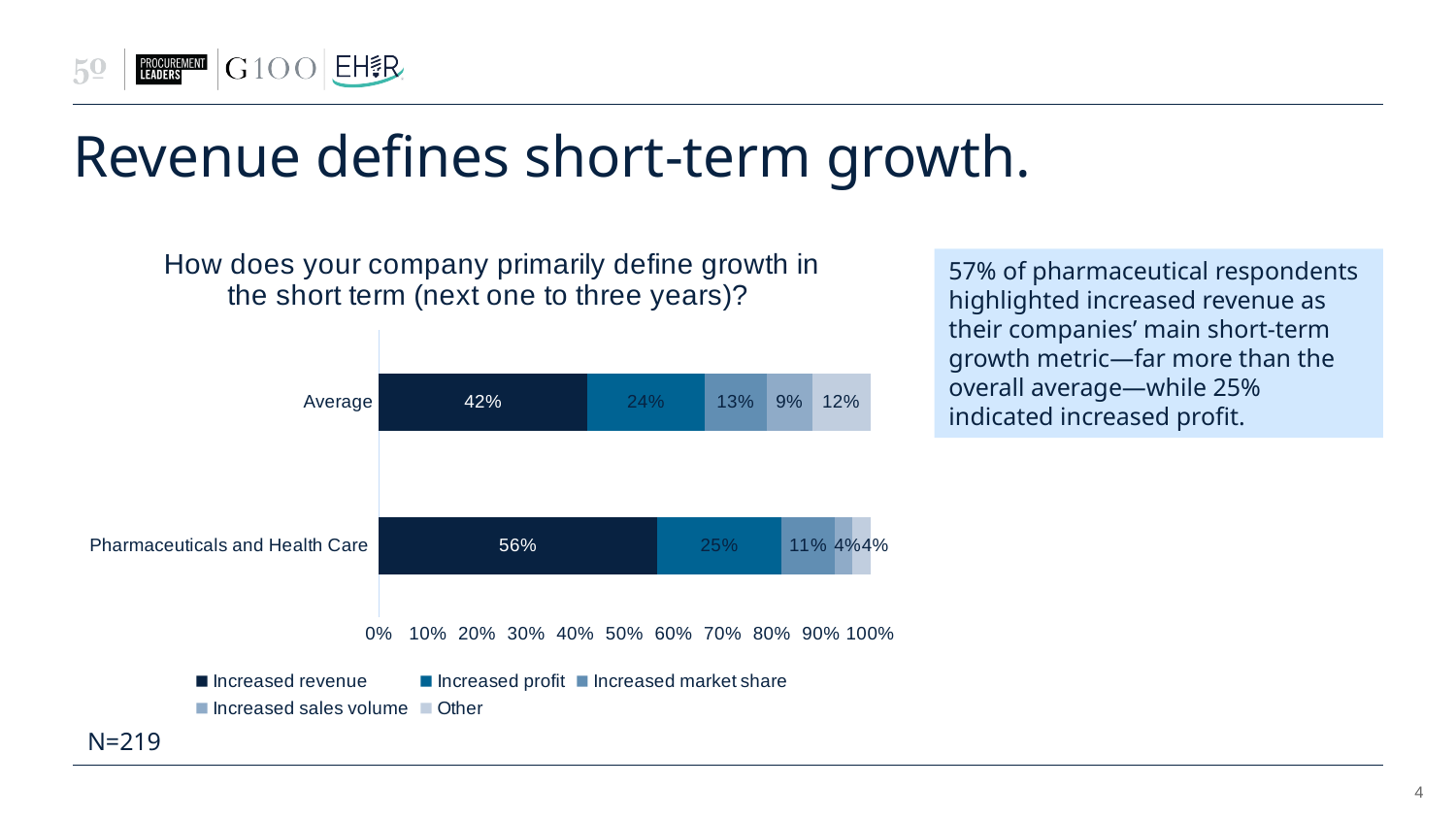
Which has a larger Increased profit value, Average or Pharmaceuticals and Health Care? Pharmaceuticals and Health Care What percentage of Pharmaceuticals and Health Care respondents chose Increased market share? 11% What is the Average value for Other? 12% Which series has the largest share in the Average bar? Increased revenue How many series does the legend list? 5 What is the sample size (N) stated on the slide? N=219 What is the Average value for Increased sales volume? 9% What is the Average value for Increased profit? 24% What percentage of Pharmaceuticals and Health Care respondents chose Increased revenue? 56% What type of chart is shown on the slide? Stacked bar chart What is the difference between the Increased revenue values for Pharmaceuticals and Health Care and Average? 14 percentage points How many categories (bars) are shown in the chart? 2